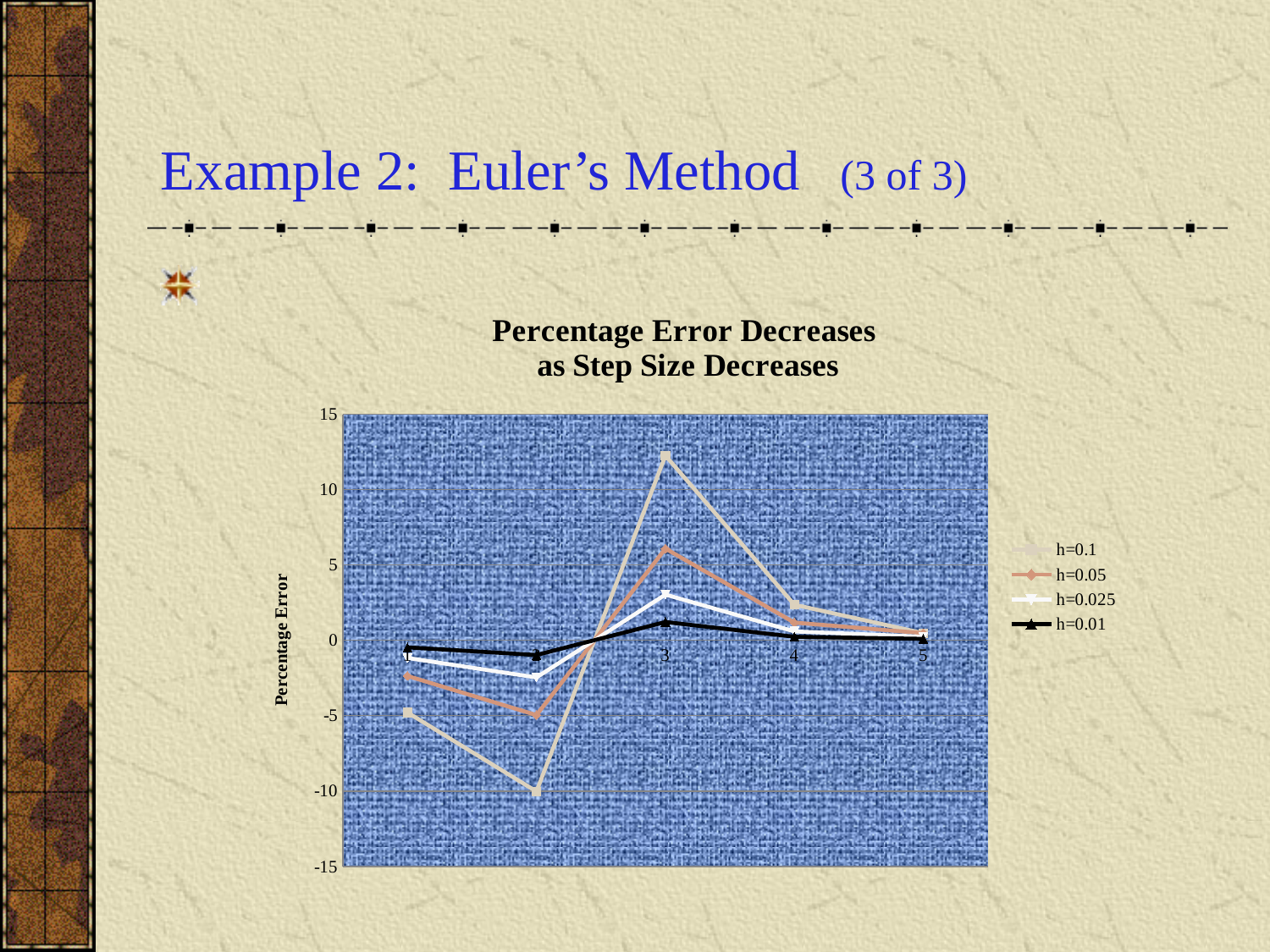
Is the value for h=0.1 at x = 3 greater or less than 10? greater What is the title of the chart? Percentage Error Decreases as Step Size Decreases How many points are labelled along the x axis? 5 At x = 3, which is larger: the value for h=0.05 or the value for h=0.025? h=0.05 Is the value for h=0.025 at x = 3 greater or less than 5? less At which x value does the h=0.1 series reach its lowest point? 2 What kind of chart is shown on the slide? line chart Is the value for h=0.1 at x = 2 greater or less than -5? less Which series has the lowest value at x = 2? h=0.1 What is the label on the vertical axis? Percentage Error Which series has the highest value at x = 3? h=0.1 How many series does the legend list? 4